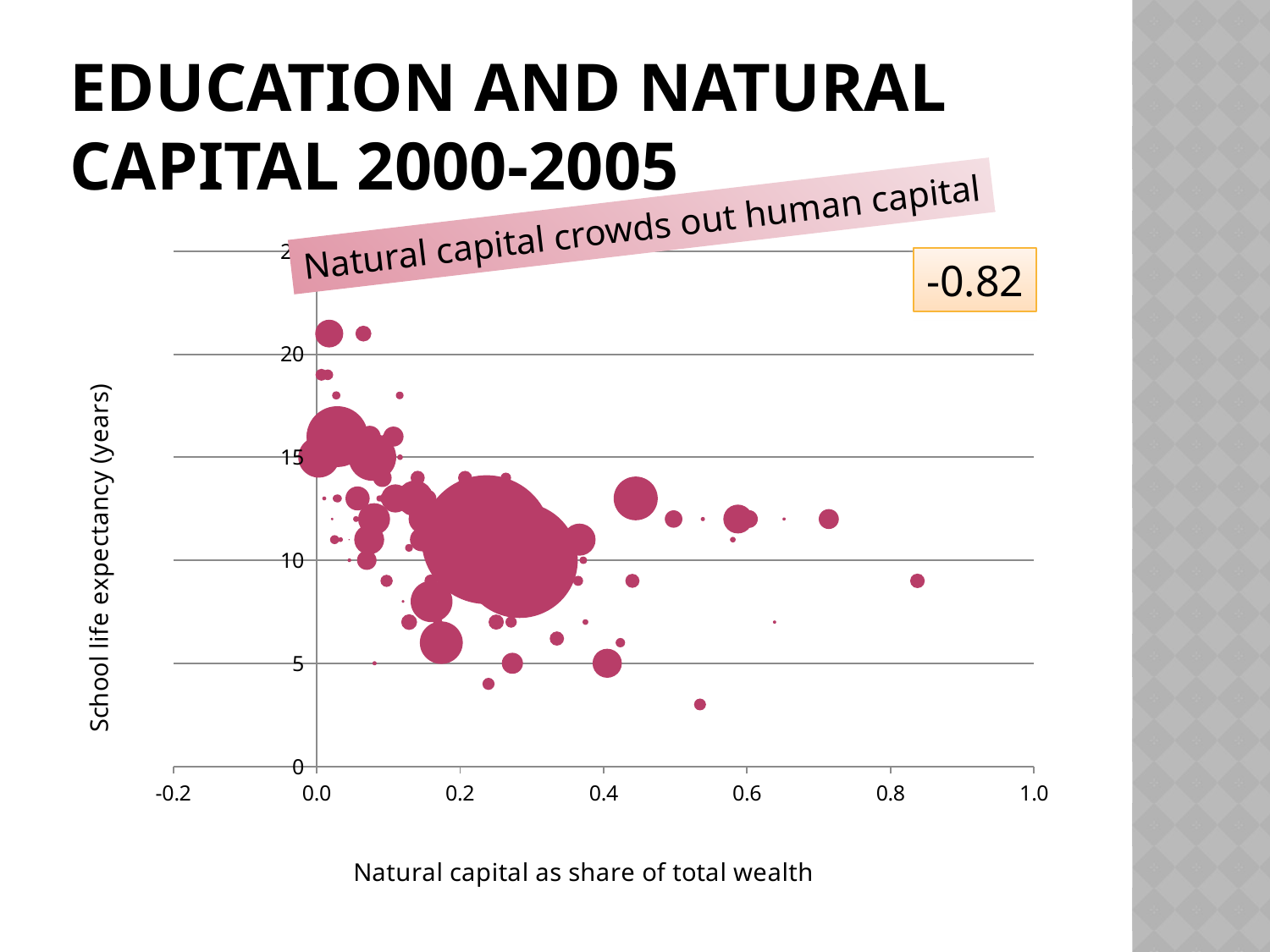
What is the title of the chart's x axis? Natural capital as share of total wealth What value is shown in the box in the upper right of the chart? -0.82 What kind of chart is shown on the slide? Bubble chart As natural capital as a share of total wealth increases along the x axis, does school life expectancy generally rise or fall? Fall